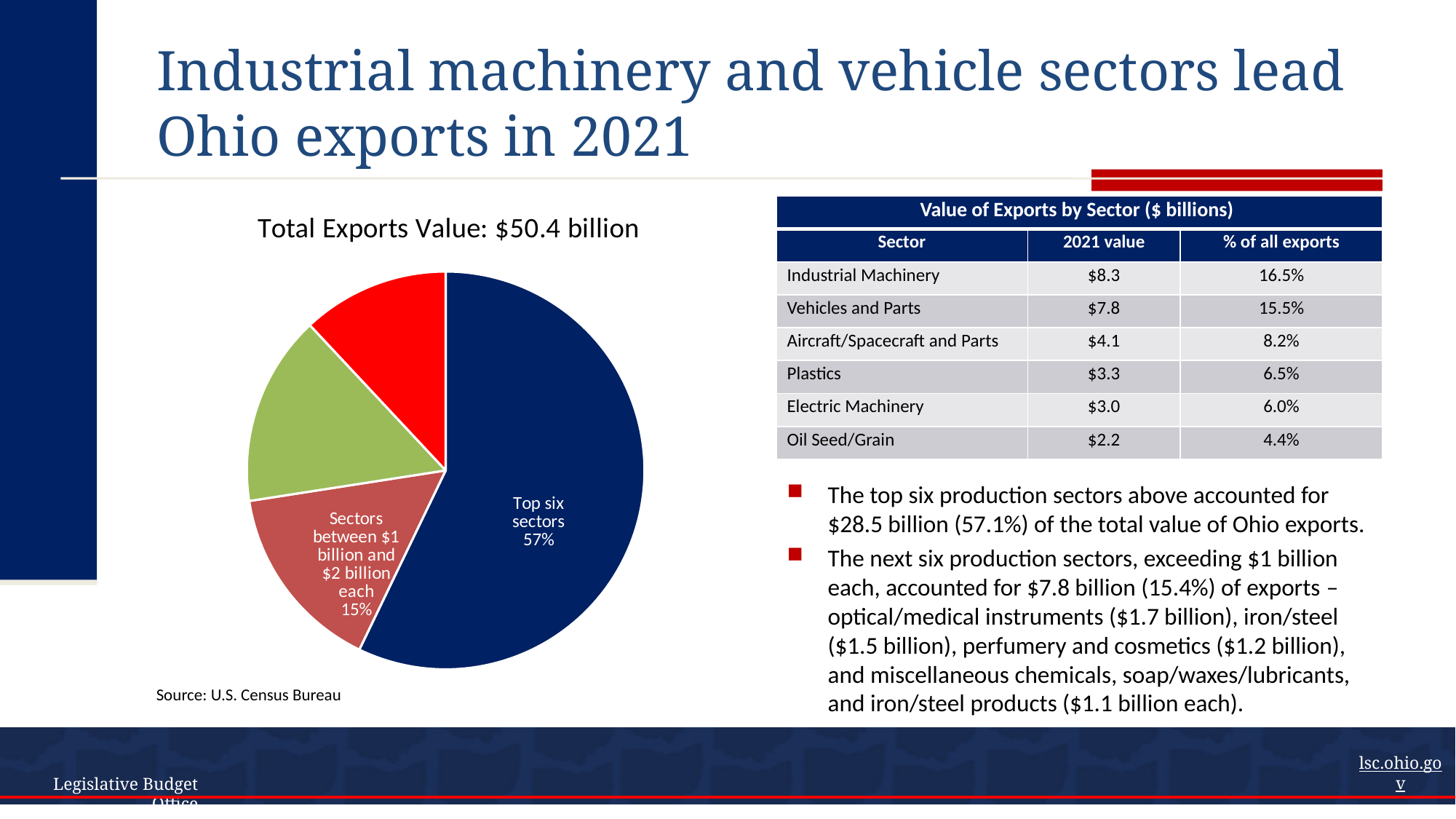
How many slices does the pie chart have? 4 What is the title of the pie chart? Total Exports Value: $50.4 billion Which is larger in the pie chart: the "Top six sectors" slice or the "Sectors between $1 billion and $2 billion each" slice? Top six sectors Which slice of the pie chart is the largest? Top six sectors What share of the pie does the "Top six sectors" slice represent? 57% What colour is the "Top six sectors" slice in the pie chart? dark blue What kind of chart is shown on the slide? pie chart By how many percentage points does the "Top six sectors" slice exceed the "Sectors between $1 billion and $2 billion each" slice? 42 percentage points What share of the pie does the "Sectors between $1 billion and $2 billion each" slice represent? 15%